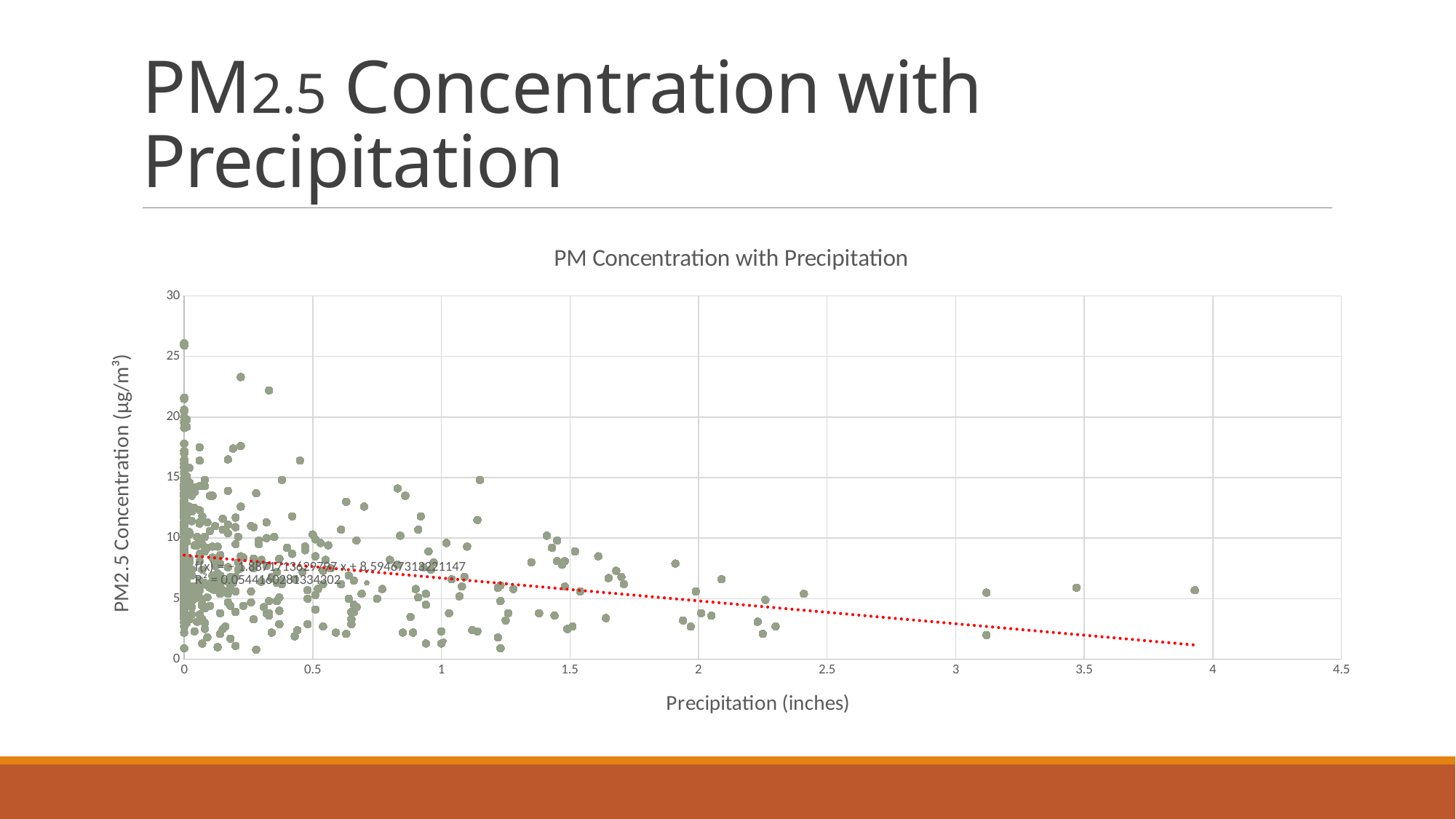
Is the PM2.5 concentration for the point at about 0.27 inches of precipitation (the highest point away from zero) greater or less than 20? greater Are the PM2.5 concentrations for the points beyond 3 inches of precipitation greater or less than 15? less What is the maximum value shown on the y axis? 30 What kind of chart is shown on the slide? Scatter chart Do the PM2.5 concentration values generally rise or fall as precipitation increases along the x axis, according to the trendline? Fall What is the label of the x axis? Precipitation (inches) What is the title of the chart? PM Concentration with Precipitation